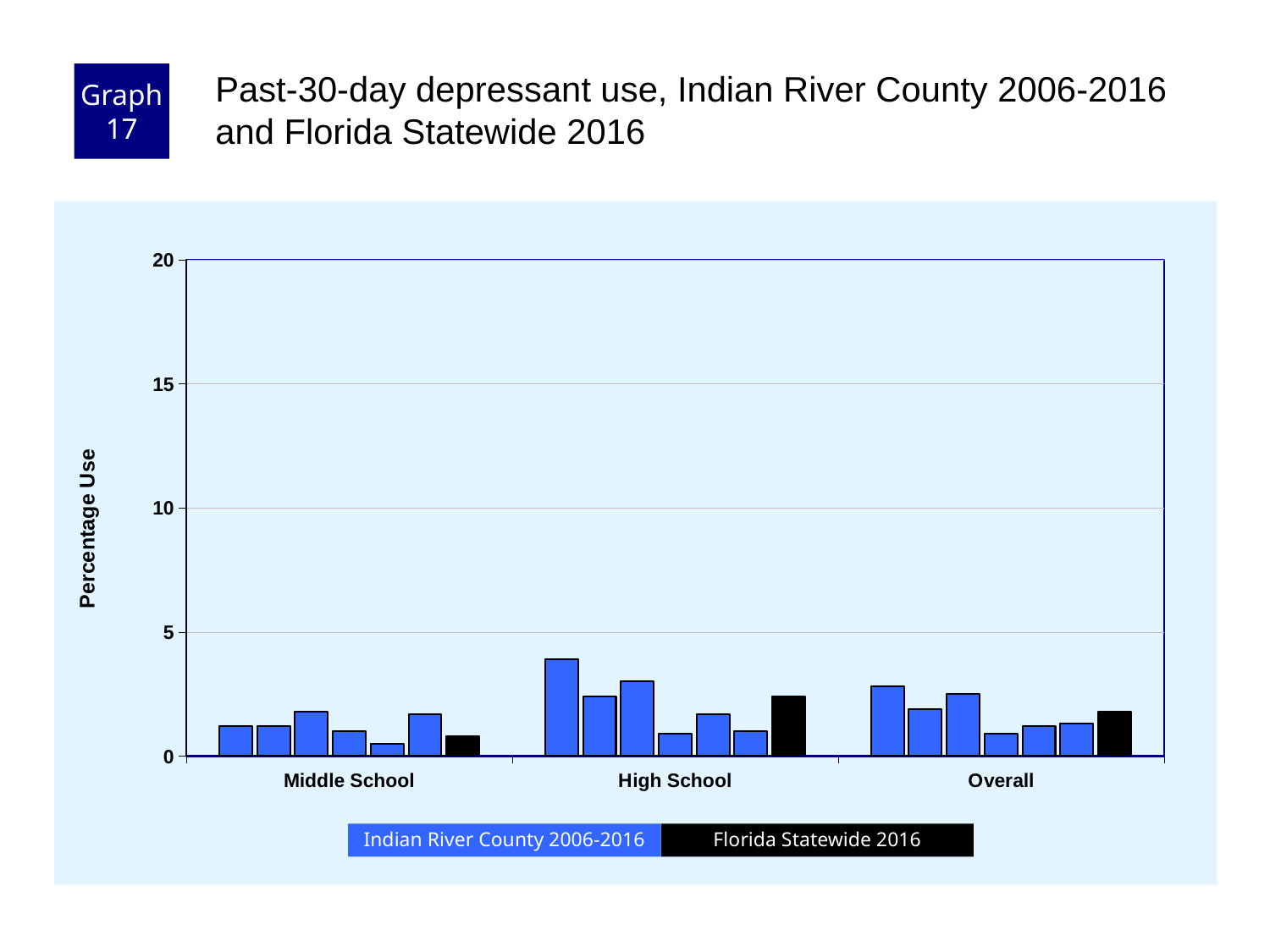
What colour represents Florida Statewide 2016 in the legend? black What is the label of the y axis? Percentage Use Which is larger, the Florida Statewide 2016 value for High School or for Middle School? High School Which is larger, the Florida Statewide 2016 value for Overall or for Middle School? Overall Is the tallest Indian River County bar in the High School group greater or less than 5? less How many categories are shown along the x axis? 3 How many series does the legend list? 2 Is the Florida Statewide 2016 value for High School greater or less than 5? less Which category contains the tallest bar in the chart? High School Which category has the lowest Florida Statewide 2016 value? Middle School Is the Florida Statewide 2016 value for Middle School greater or less than 5? less What kind of chart is shown on the slide? bar chart